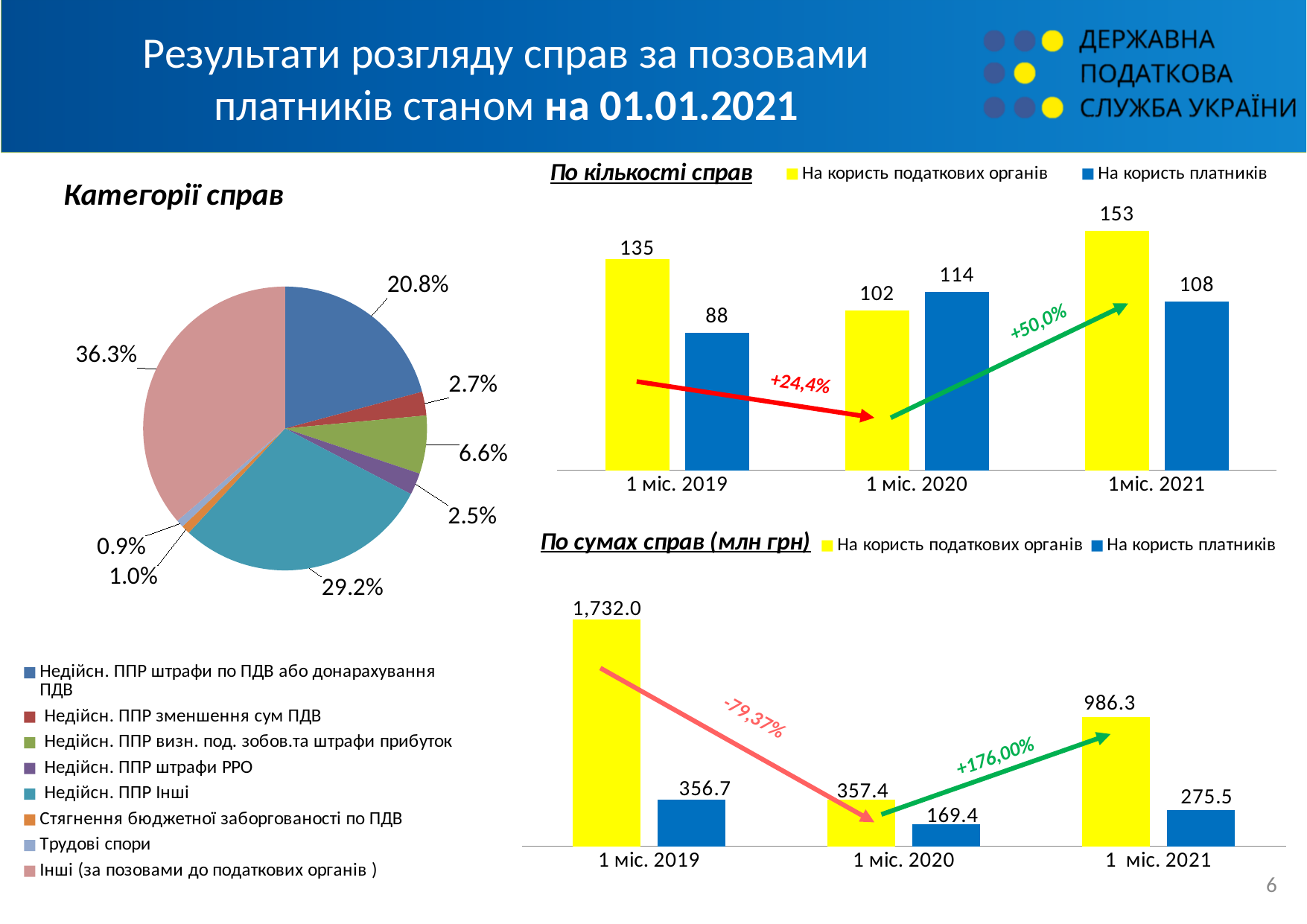
How many categories does the legend of the 'Категорії справ' pie chart list? 8 In the 'По кількості справ' chart, what is the difference between the two series in 1 міс. 2020? 12 In the 'Категорії справ' pie chart, what share does 'Недійсн. ППР Інші' have? 29.2% In the 'По кількості справ' chart, which period has the highest value for 'На користь платників'? 1 міс. 2020 In the 'По сумах справ (млн грн)' chart, which is larger in 1 міс. 2021: 'На користь податкових органів' or 'На користь платників'? На користь податкових органів What kind of chart is 'По кількості справ'? bar chart In the 'По сумах справ (млн грн)' chart, which period has the lowest value for 'На користь податкових органів'? 1 міс. 2020 In the 'По сумах справ (млн грн)' chart, what is the value for 'На користь платників' in 1 міс. 2020? 169.4 In the 'Категорії справ' pie chart, which category has the largest share? Інші (за позовами до податкових органів ) In the 'По кількості справ' chart, what is the value for 'На користь платників' in 1 міс. 2019? 88 In the 'По кількості справ' chart, what is the value for 'На користь податкових органів' in 1 міс. 2021? 153 In the 'По сумах справ (млн грн)' chart, what is the value for 'На користь податкових органів' in 1 міс. 2019? 1,732.0